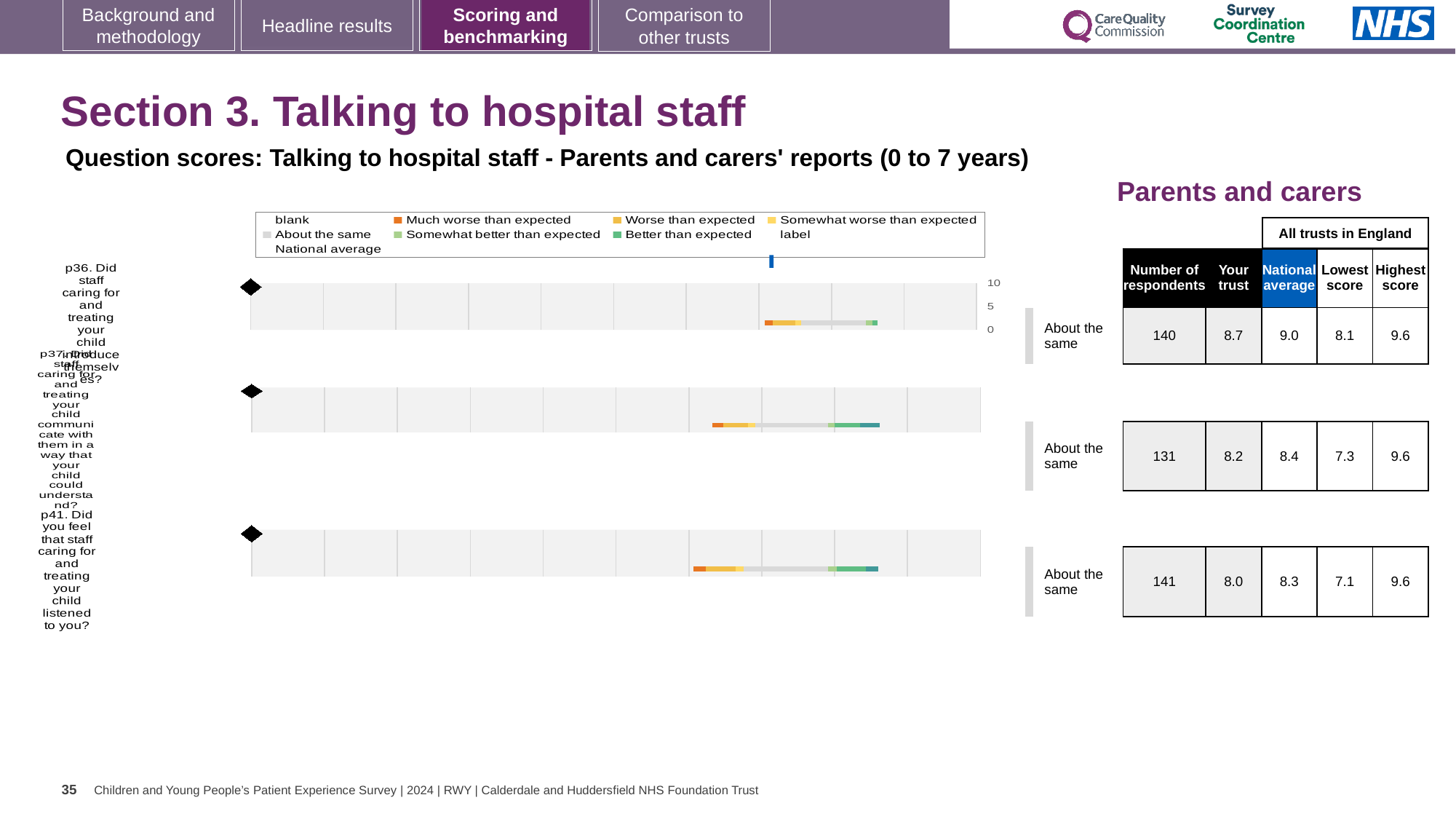
What is the national average score for p37 (Did staff communicate with your child in a way they could understand?)? 8.4 What kind of chart is used to show each question's benchmark? Bar chart What benchmark category is shown for p41? About the same For p36, what is the difference between the national average and the 'Your trust' score? 0.3 In the table next to the charts, what is the 'Your trust' score for p36 (Did staff caring for and treating your child introduce themselves?)? 8.7 Which question has the lowest 'Lowest score' across all trusts in England? p41 For p41, what is the difference between the highest score and the lowest score across all trusts in England? 2.5 What is the highest score across all trusts in England for p37? 9.6 How many respondents answered p41 (Did you feel that staff listened to you?)? 141 Which of the three questions has the highest 'Your trust' score? p36 How many question charts are shown on the slide? 3 For p37, which is larger: the 'Your trust' score or the national average? National average